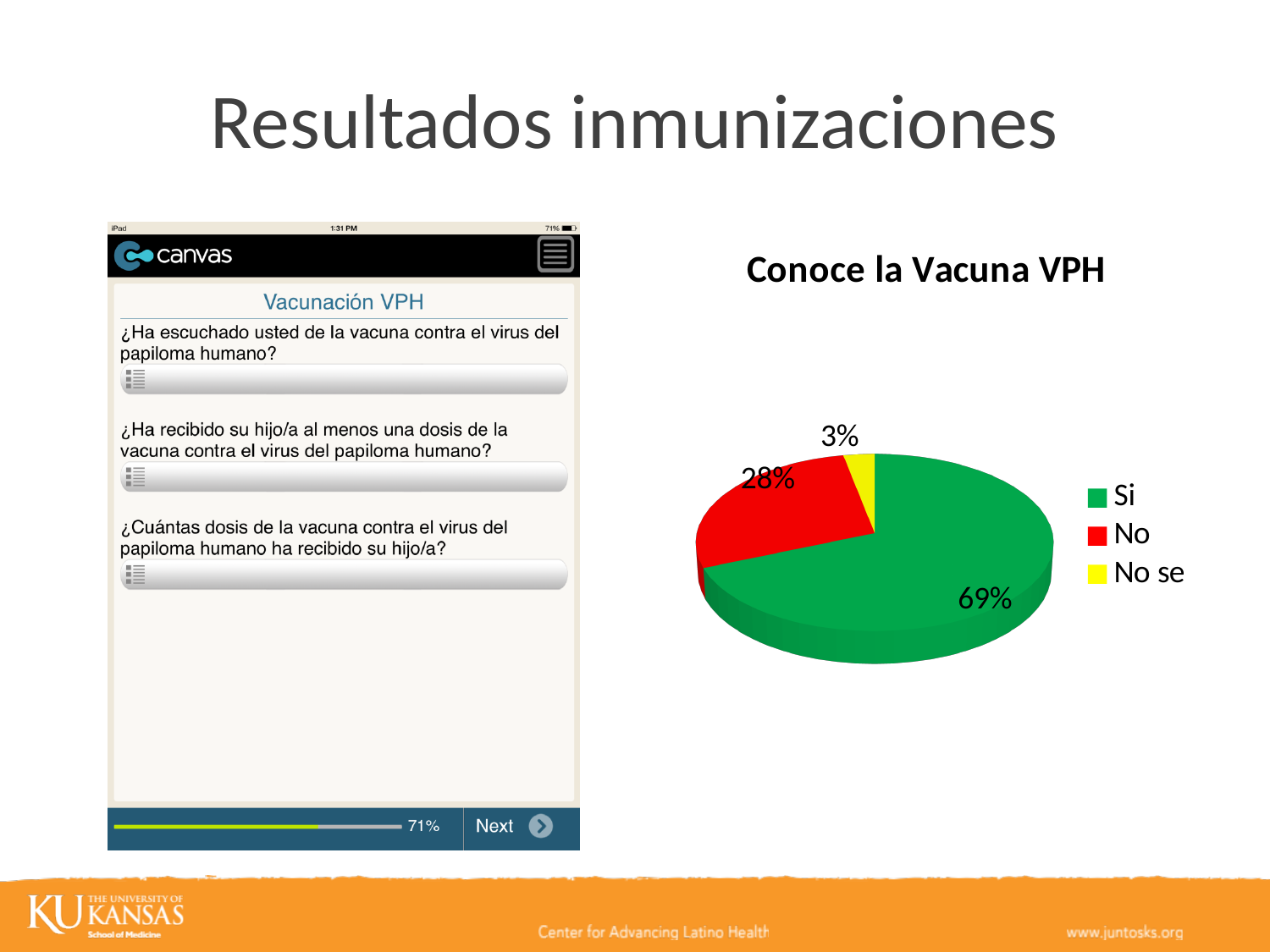
How many categories does the pie chart show? 3 What colour is the "No" slice in the pie chart? red Which is larger in the pie chart, "No" or "No se"? No What is the difference between the "Si" and "No" values in the pie chart? 41% What is the difference between the "No" and "No se" values in the pie chart? 25% Which category has the smallest slice in the pie chart? No se Which category has the largest slice in the pie chart? Si What is the title of the pie chart? Conoce la Vacuna VPH What is the value for "No se" in the pie chart? 3% What is the value for "Si" in the pie chart? 69% What is the value for "No" in the pie chart? 28% What kind of chart is shown under the title "Conoce la Vacuna VPH"? pie chart